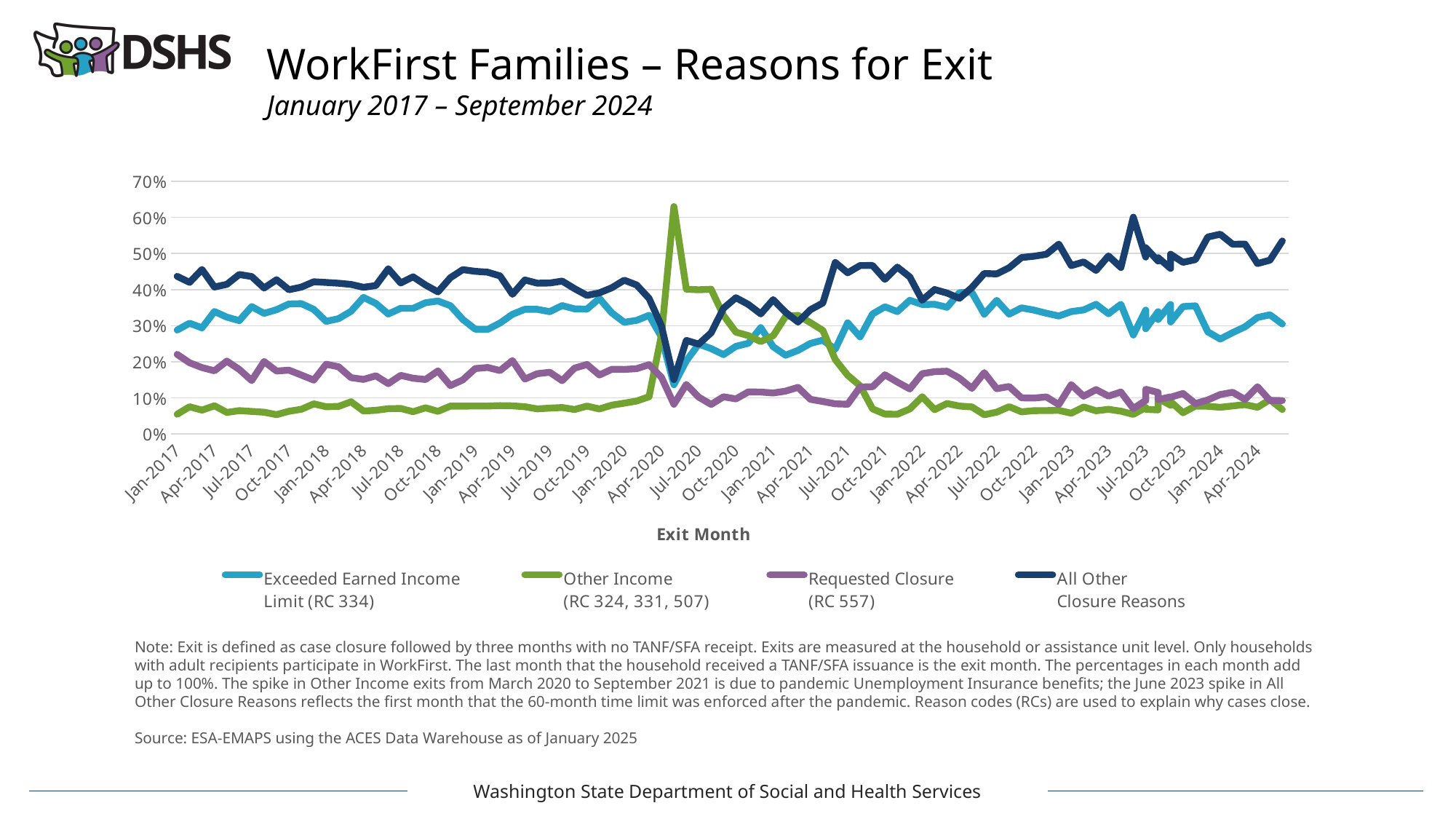
What kind of chart is shown on the slide? line chart Is the value for Requested Closure (RC 557) in Jan-2017 greater or less than 30%? less Does the Other Income (RC 324, 331, 507) line rise or fall between Jul-2021 and Jan-2022? fall Is the peak value of the Other Income (RC 324, 331, 507) line in mid-2020 greater or less than 50%? greater Is the value for Other Income (RC 324, 331, 507) in Jan-2017 greater or less than 10%? less Around Jul-2020, which series is higher: Other Income (RC 324, 331, 507) or All Other Closure Reasons? Other Income (RC 324, 331, 507) What is the title of the slide's chart? WorkFirst Families – Reasons for Exit How many series does the legend list? 4 Which series has the highest value at Apr-2024? All Other Closure Reasons In Jan-2017, which series is higher: All Other Closure Reasons or Exceeded Earned Income Limit (RC 334)? All Other Closure Reasons What is the title of the chart's x axis? Exit Month